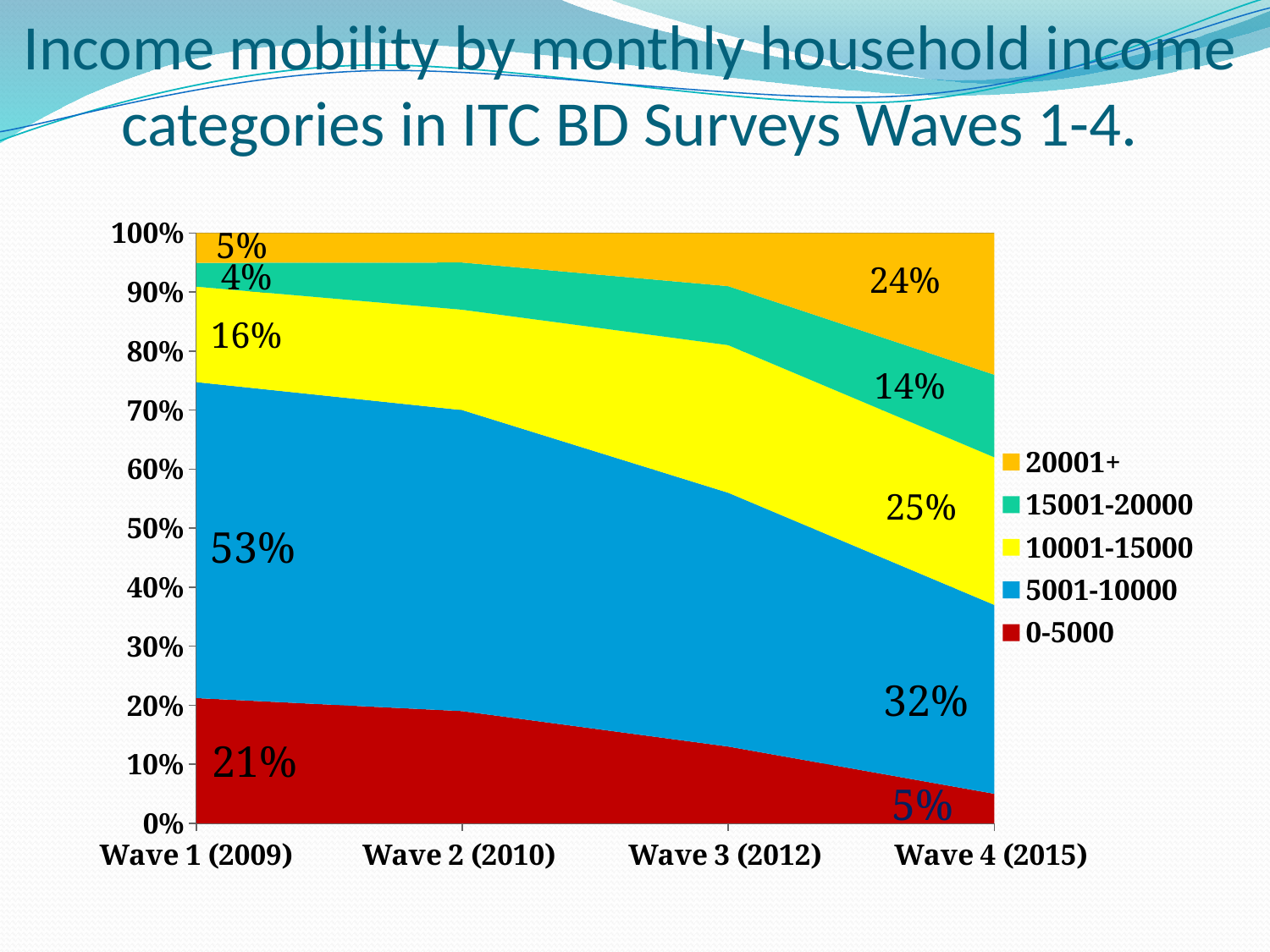
Which income category has the smallest share in Wave 4 (2015)? 0-5000 What share of households were in the 0-5000 income category in Wave 1 (2009)? 21% Which income category has the largest share in Wave 1 (2009)? 5001-10000 What share of households were in the 10001-15000 income category in Wave 1 (2009)? 16% How many survey waves are shown on the x axis? 4 What share of households were in the 20001+ income category in Wave 4 (2015)? 24% Which wave has the larger share in the 20001+ category, Wave 1 (2009) or Wave 4 (2015)? Wave 4 (2015) What share of households were in the 5001-10000 income category in Wave 4 (2015)? 32% What kind of chart is shown on the slide? Stacked area chart What share of households were in the 15001-20000 income category in Wave 4 (2015)? 14% By how many percentage points did the 0-5000 share fall from Wave 1 (2009) to Wave 4 (2015)? 16 percentage points How many income categories does the legend list? 5